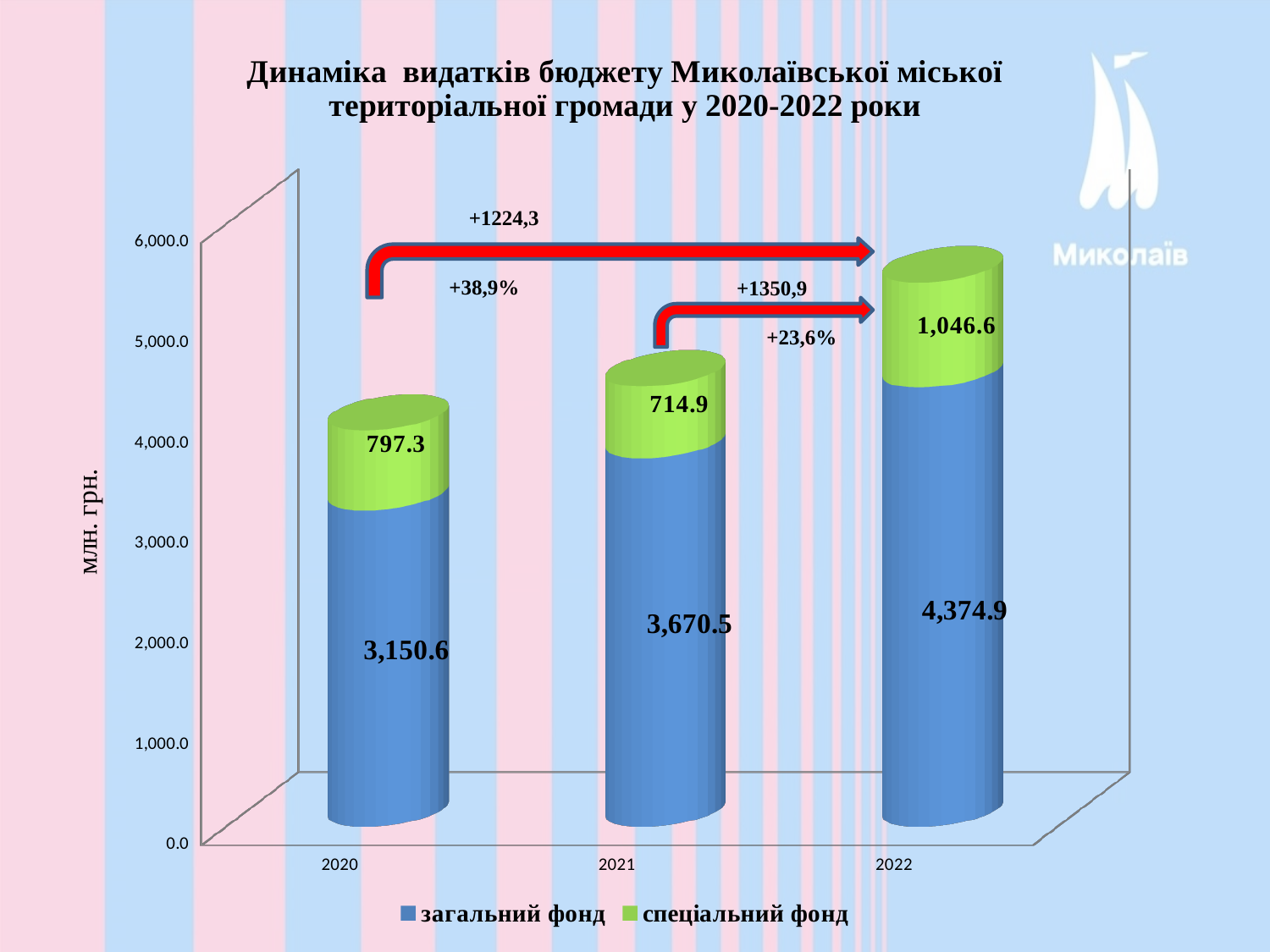
What is the difference between the загальний фонд values for 2022 and 2020? 1,224.3 How many series does the legend list? 2 Which year has the lowest value for спеціальний фонд? 2021 What is the value of спеціальний фонд for 2022? 1,046.6 What is the total of the stacked bar for 2022? 5,421.5 Does the загальний фонд value rise or fall from 2020 to 2022? rise How many years are shown on the x axis? 3 Which year has the highest value for загальний фонд? 2022 What type of chart is shown on the slide? stacked bar chart What is the value of загальний фонд for 2021? 3,670.5 What is the value of спеціальний фонд for 2020? 797.3 Which is larger: спеціальний фонд in 2020 or in 2021? 2020